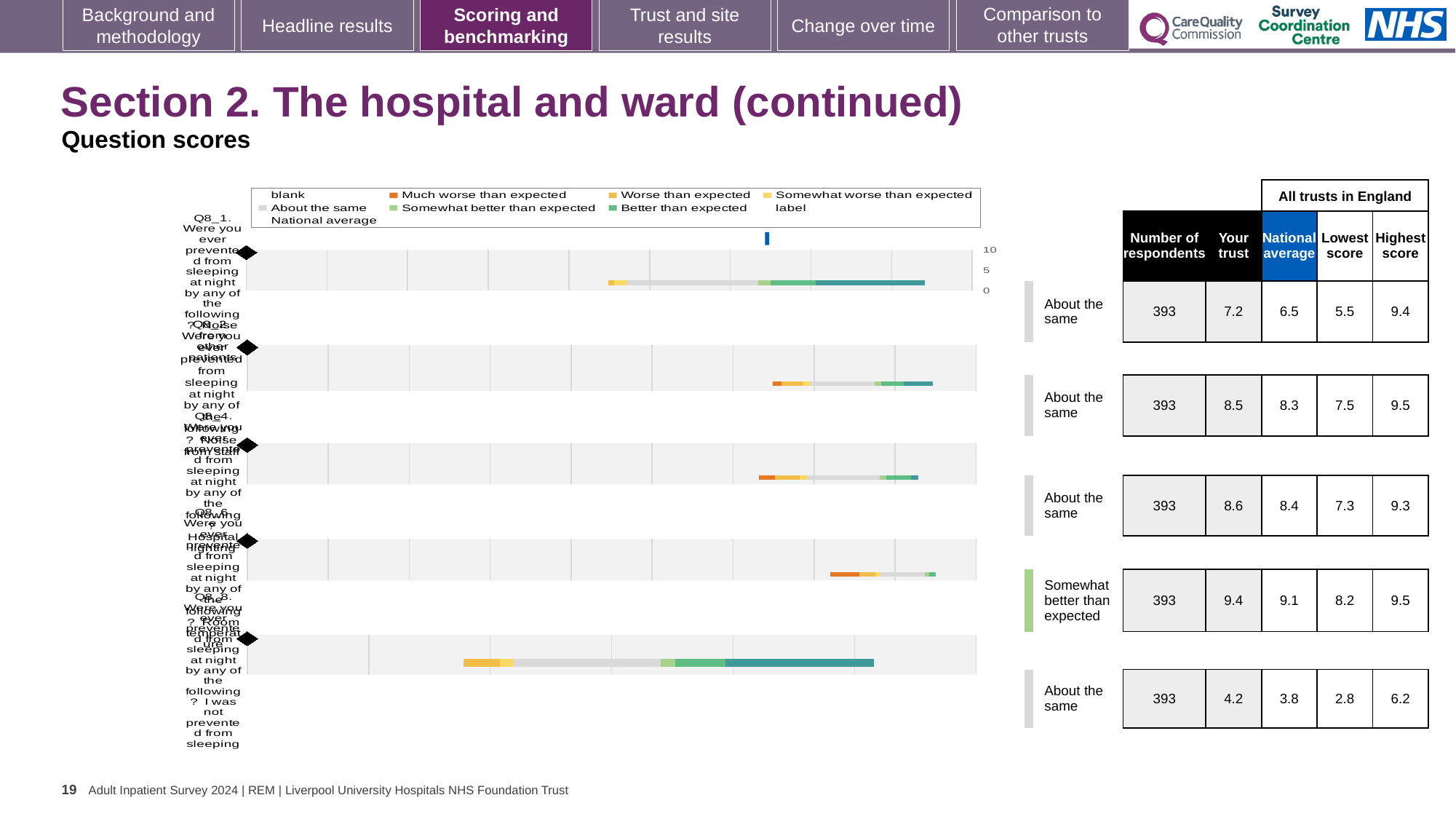
What is the 'Your trust' score for the first (top) question row? 7.2 For the fourth question row, which is larger: the 'Your trust' score or the national average? Your trust (9.4) What is the national average for the first (top) question row? 6.5 How many question rows (bars) are shown in the chart area? 5 For the first (top) question row, what is the difference between the 'Your trust' score and the national average? 0.7 Which question row has the lowest 'Your trust' score? the fifth (bottom) row (4.2) Which question row has the highest 'Your trust' score? the fourth row (9.4) What is the lowest score among all trusts in England for the fourth question row? 8.2 Which question row is rated 'Somewhat better than expected' rather than 'About the same'? the fourth row How many respondents are listed for each question row? 393 What is the highest score among all trusts in England for the fifth (bottom) question row? 6.2 What kind of chart is used to show the question scores on this slide? bar chart